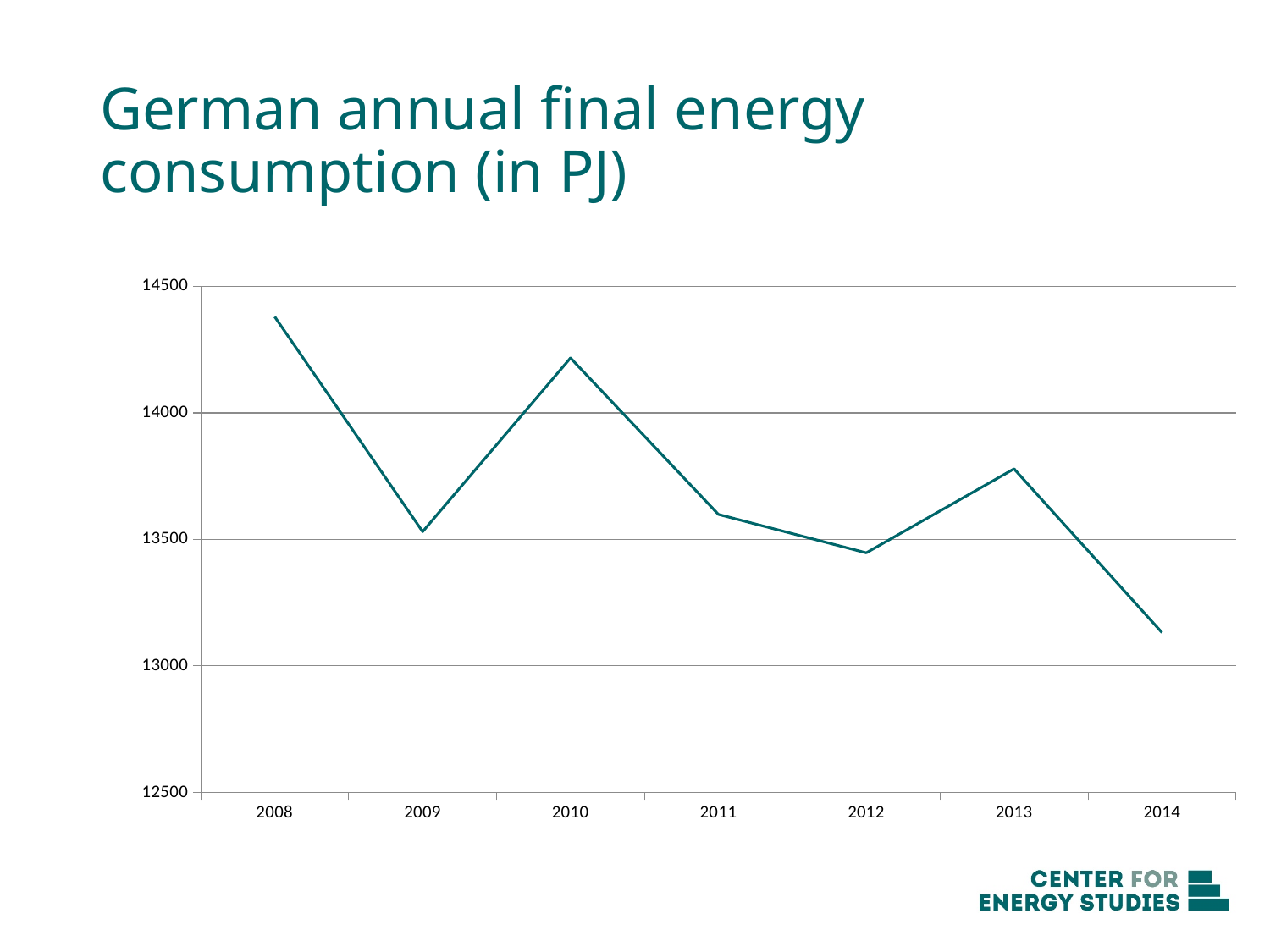
Is the value for 2014 greater or less than 13000? greater Is the value for 2008 greater or less than 14000? greater Overall, do the values rise or fall from 2008 to 2014? fall Is the value for 2013 greater or less than 13500? greater Which year has the higher value, 2009 or 2013? 2013 Which year has the highest final energy consumption? 2008 How many years are plotted on the x axis? 7 Which year has the lowest final energy consumption? 2014 Which year has the higher value, 2008 or 2010? 2008 What kind of chart is shown on the slide? line chart